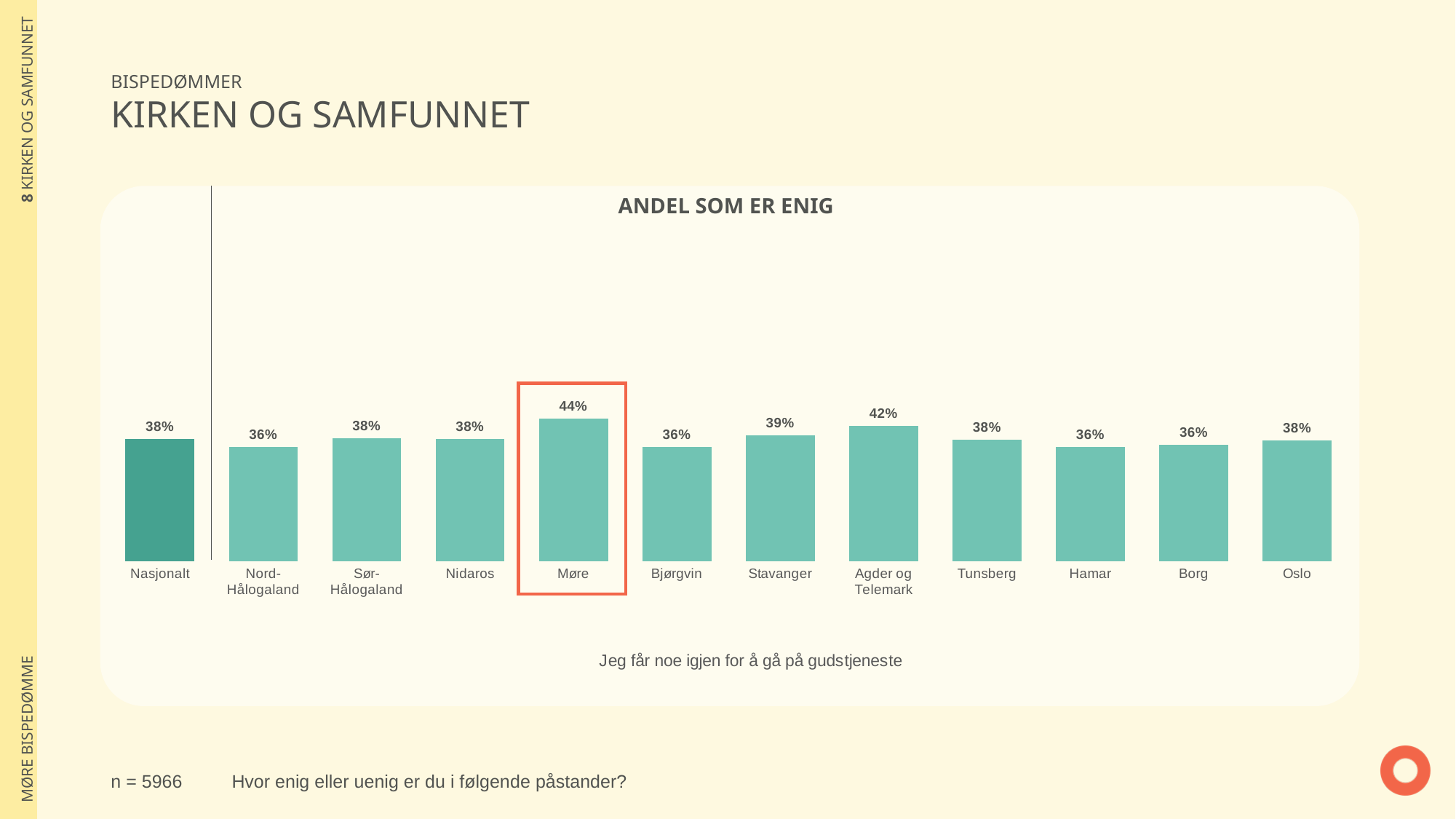
Which is larger, the value for Stavanger or the value for Hamar? Stavanger What is the value for Stavanger? 39% What is the difference between the values for Møre and Nasjonalt? 6% What kind of chart is shown? Bar chart Which category has the highest value? Møre What is the difference between the values for Agder og Telemark and Bjørgvin? 6% What is the value for Møre? 44% What is the value for Nasjonalt? 38% What is the title of the chart? ANDEL SOM ER ENIG Which category is highlighted with a red outline? Møre How many categories are shown on the x axis? 12 What is the value for Agder og Telemark? 42%